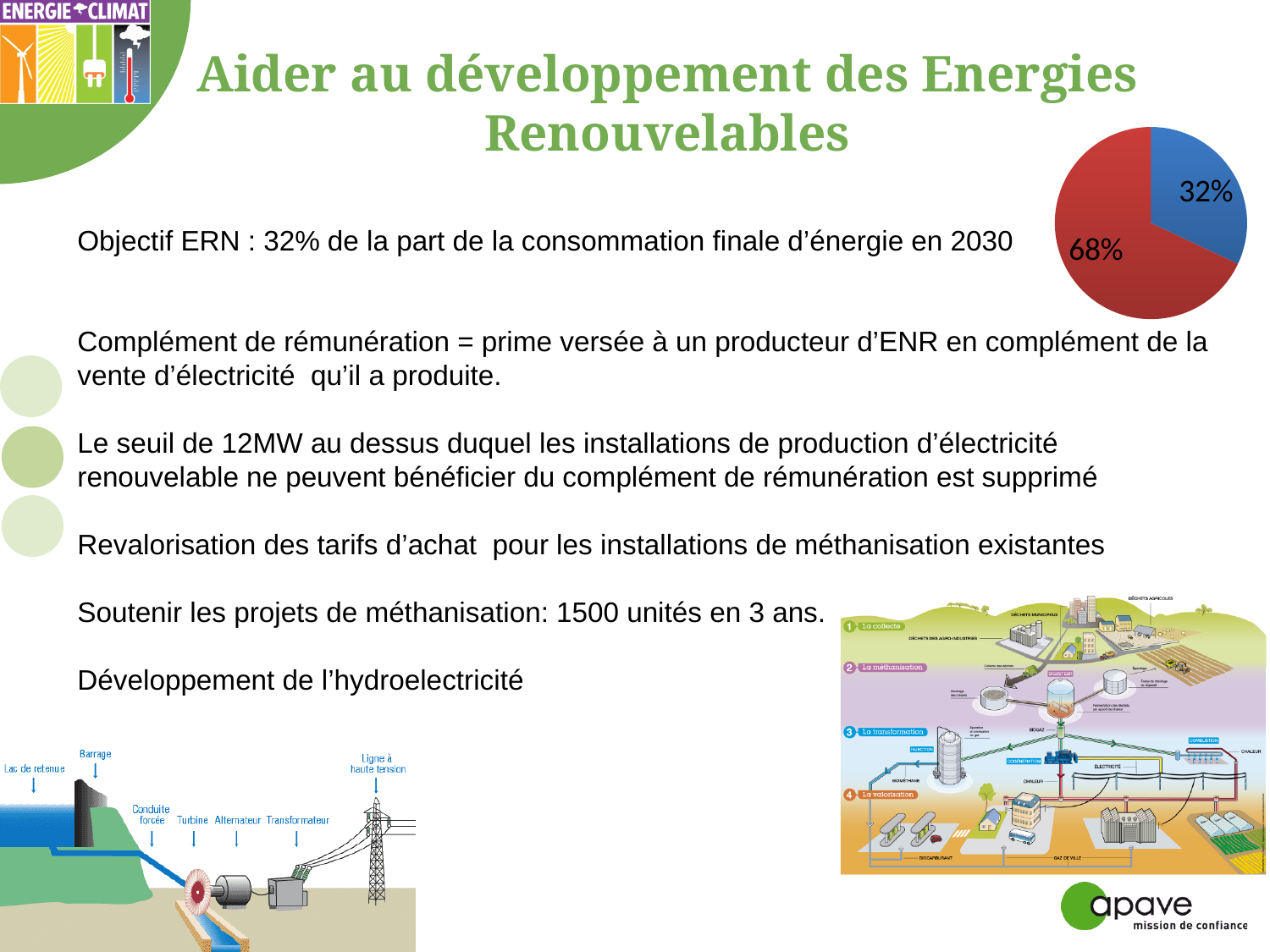
Which slice of the pie chart is the largest? the red slice (68%) What colour is the slice labelled 32% in the pie chart? blue How many slices does the pie chart have? 2 Does the pie chart have a legend? No What is the total of the two percentages shown on the pie chart? 100% What percentage is shown on the blue slice of the pie chart? 32% What percentage is shown on the red slice of the pie chart? 68% Which is larger in the pie chart, the blue slice or the red slice? the red slice Which slice of the pie chart is the smallest? the blue slice (32%) What kind of chart is shown in the top right of the slide? pie chart What is the difference in percentage points between the red slice and the blue slice of the pie chart? 36